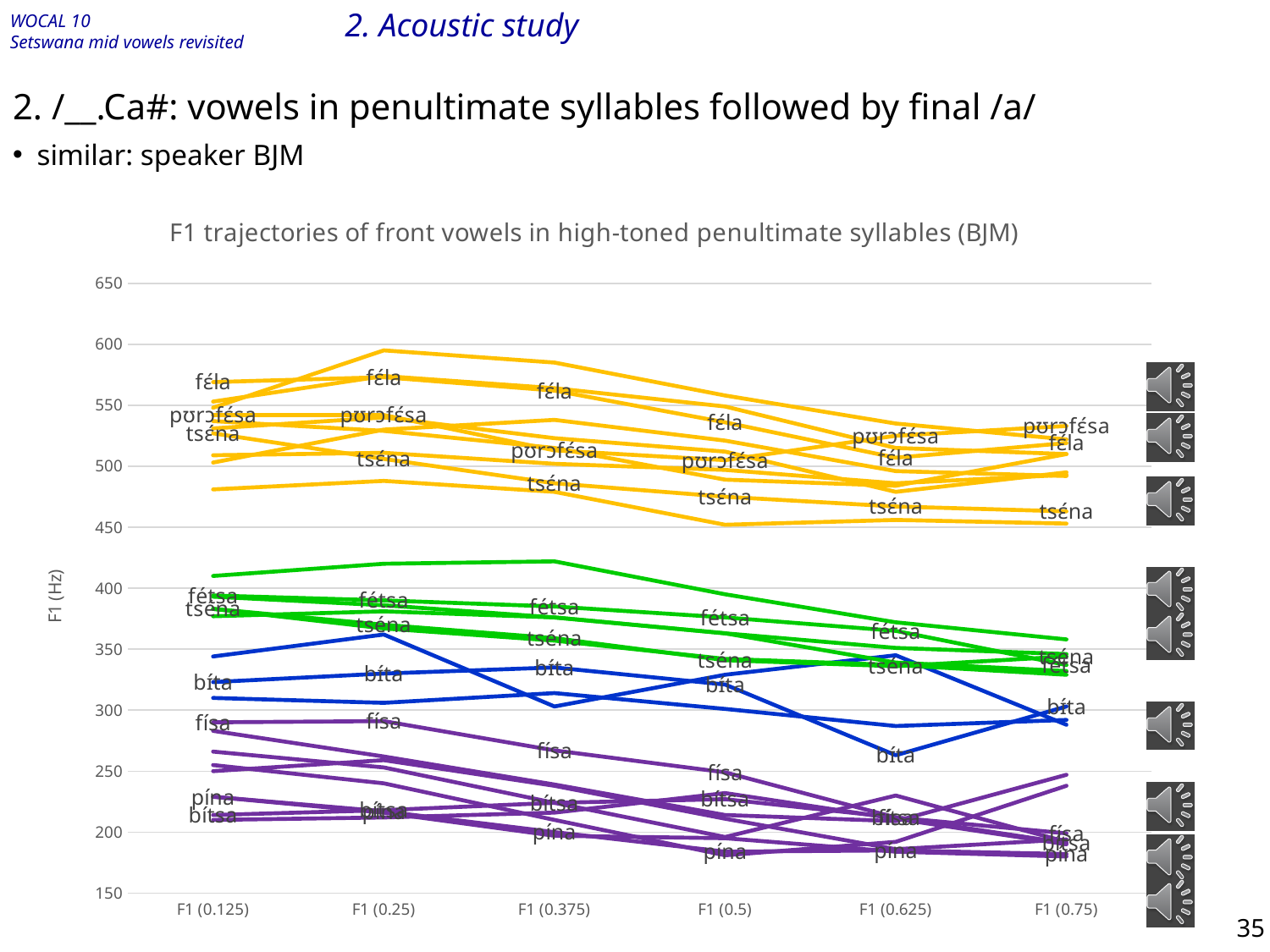
At F1 (0.125), is the highest yellow line larger or smaller than the highest green line? larger Which colour group of lines has the highest F1 values in the chart? yellow Is the highest green line at F1 (0.375) greater or less than 400? greater Is the highest value plotted at F1 (0.25) greater or less than 550? greater What kind of chart is shown on the slide? line chart Is the highest value plotted at F1 (0.75) greater or less than 600? less How many different line colours are used in the chart? 4 Which colour group of lines has the lowest F1 values in the chart? purple Do the yellow lines generally rise or fall from F1 (0.125) to F1 (0.75)? fall How many time points are shown along the x axis of the chart? 6 What is the title of the chart? F1 trajectories of front vowels in high-toned penultimate syllables (BJM)